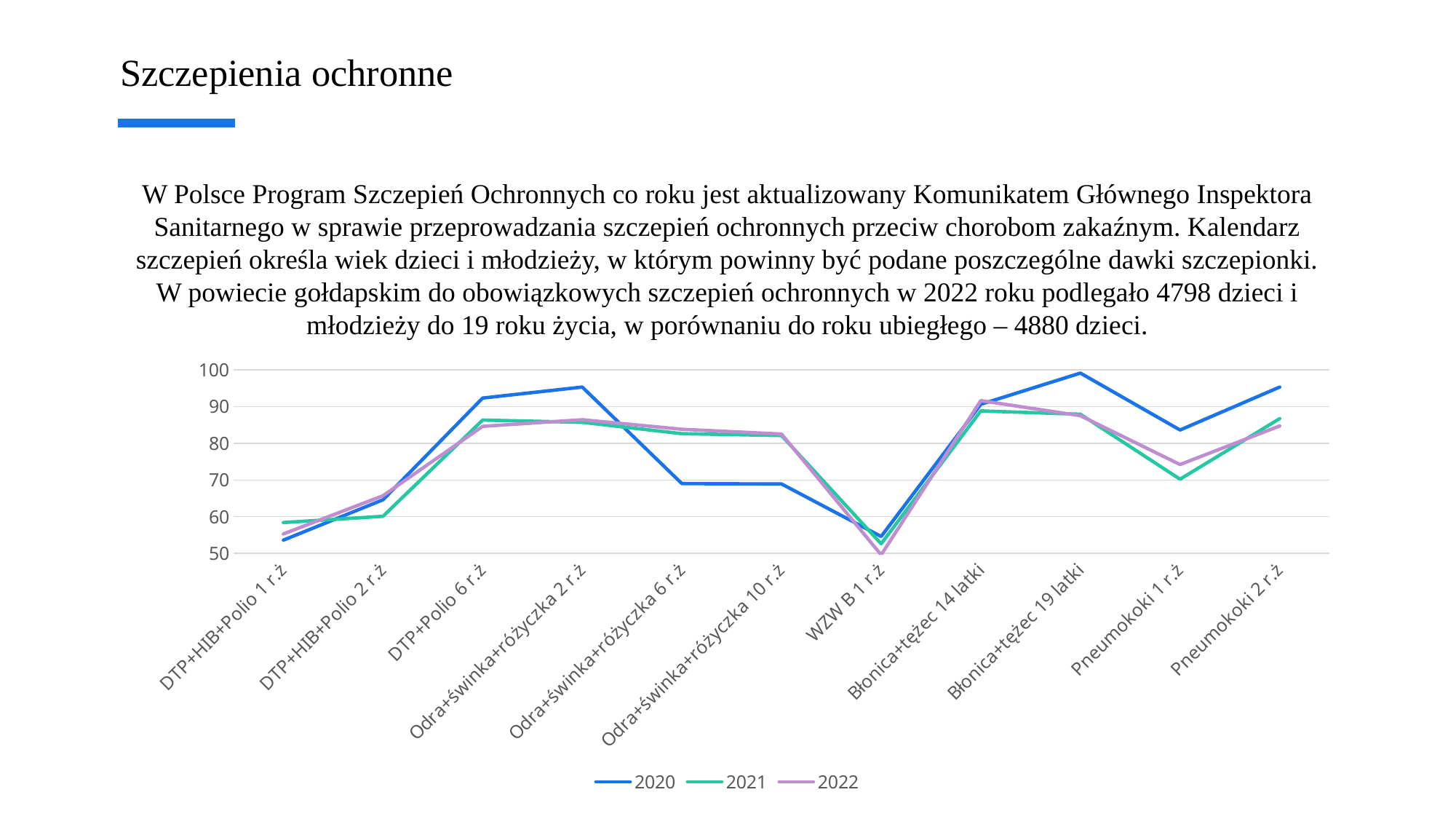
For Pneumokoki 1 r.ż, which series has the larger value, 2020 or 2021? 2020 For the 2020 series, which category has the highest value? Błonica+tężec 19 latki How many series does the chart legend list? 3 Is the 2020 value for Odra+świnka+różyczka 6 r.ż greater or less than 80? less Is the 2021 value for Pneumokoki 1 r.ż greater or less than 80? less For the 2021 series, which category has the lowest value? WZW B 1 r.ż For Odra+świnka+różyczka 6 r.ż, which series has the larger value, 2020 or 2021? 2021 Which series does the chart legend list? 2020, 2021, 2022 For the 2022 series, which category has the lowest value? WZW B 1 r.ż Is the 2020 value for Błonica+tężec 19 latki greater or less than 90? greater What kind of chart is shown on the slide? line chart How many categories are shown on the x axis of the chart? 11